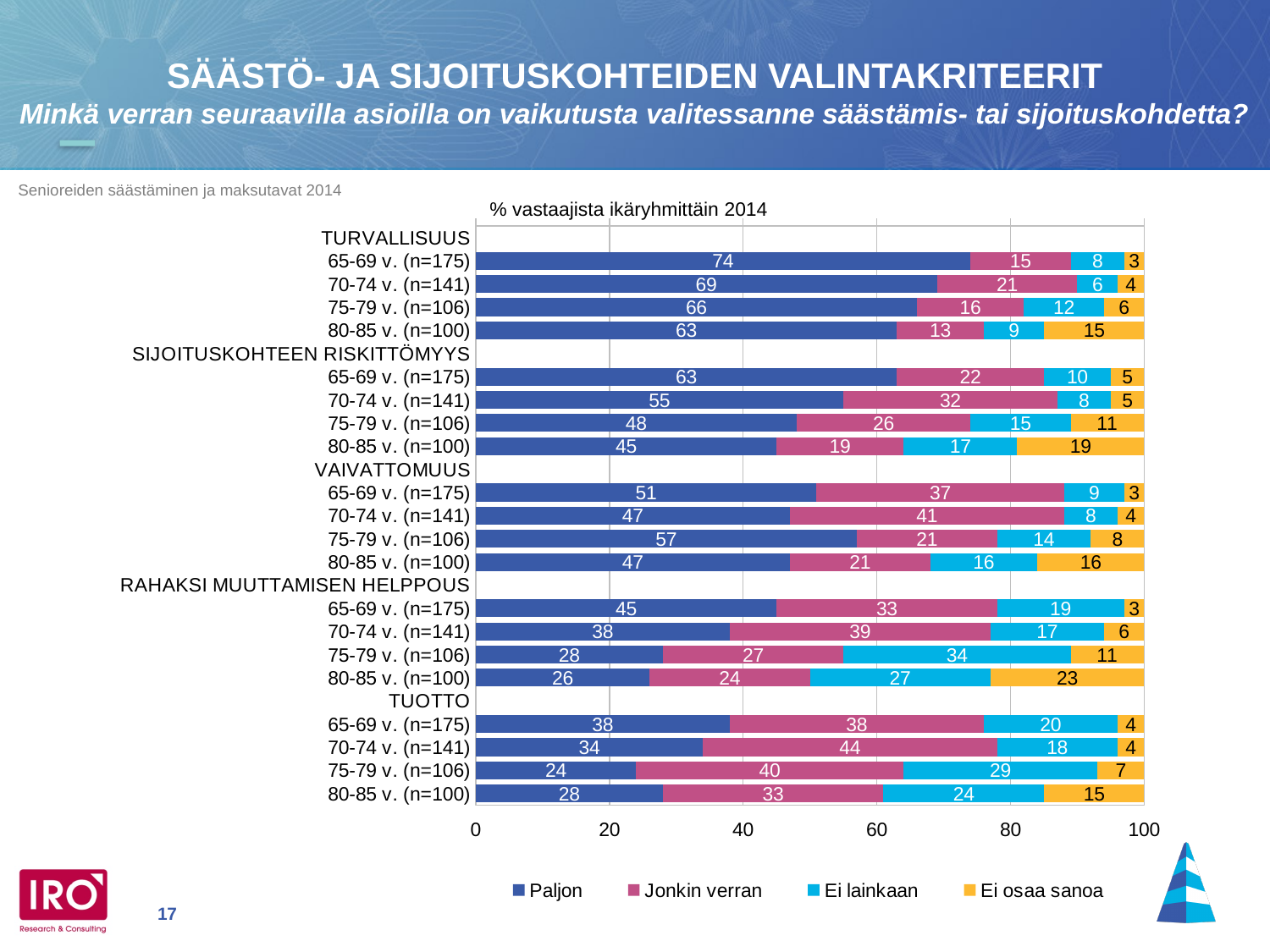
Which bar has the lowest "Paljon" value on the chart? TUOTTO, 75-79 v. (n=106) What is the total of the stacked bar for 80-85 v. (n=100) under TURVALLISUUS? 100 What is the label of the series shown in yellow in the legend? Ei osaa sanoa What kind of chart is shown on the slide? Stacked bar chart Which bar has the highest "Paljon" value on the chart? TURVALLISUUS, 65-69 v. (n=175) Under VAIVATTOMUUS, which age group has the larger "Jonkin verran" value: 65-69 v. or 75-79 v.? 65-69 v. (n=175) What is the difference between the "Paljon" values for 65-69 v. and 80-85 v. under SIJOITUSKOHTEEN RISKITTÖMYYS? 18 What is the "Jonkin verran" value for the 70-74 v. (n=141) group under TUOTTO? 44 What is the "Paljon" value for the 65-69 v. (n=175) group under TURVALLISUUS? 74 How many series does the legend list? 4 What is the "Ei osaa sanoa" value for the 80-85 v. (n=100) group under RAHAKSI MUUTTAMISEN HELPPOUS? 23 What is the "Ei lainkaan" value for the 75-79 v. (n=106) group under SIJOITUSKOHTEEN RISKITTÖMYYS? 15